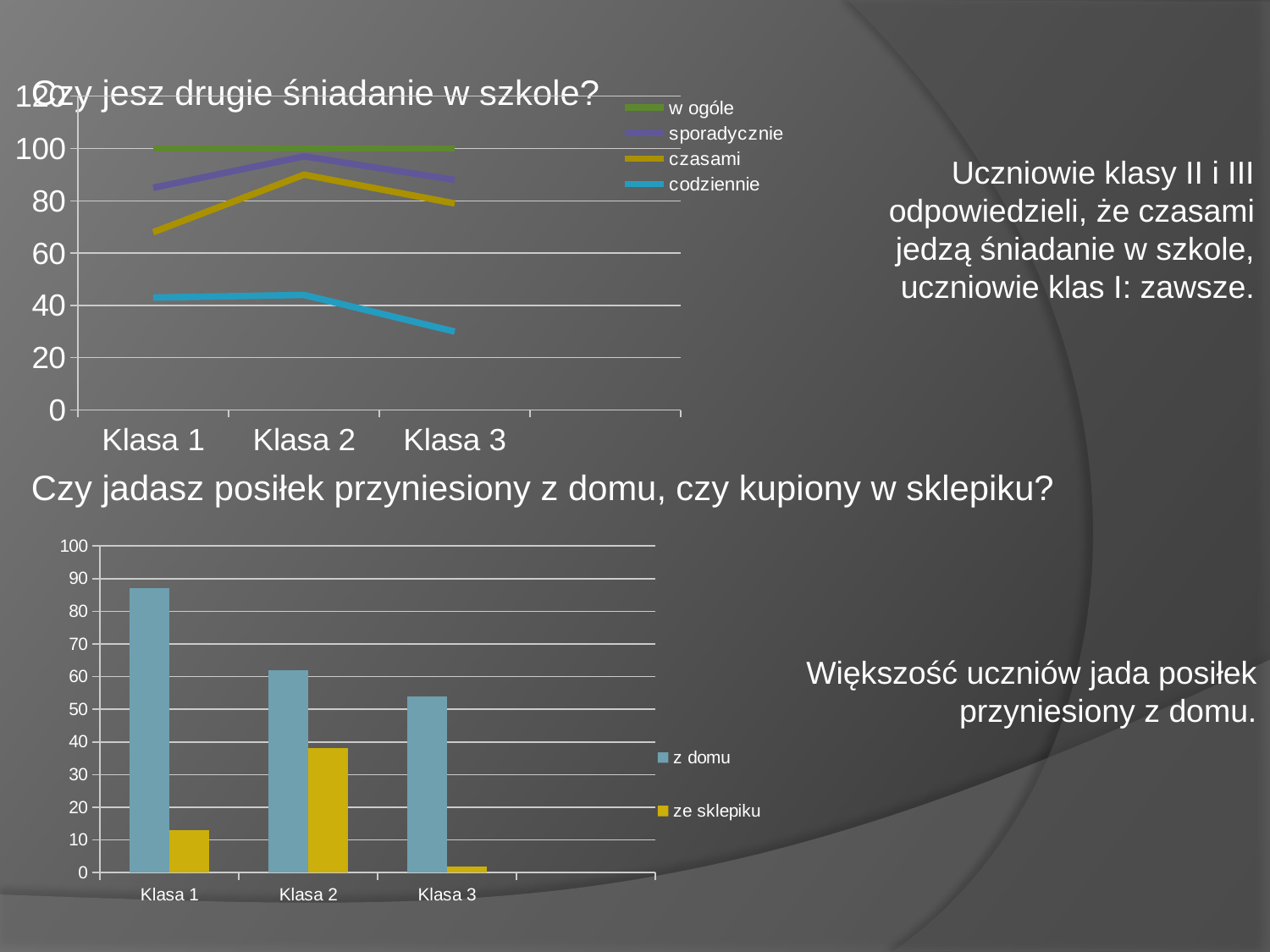
In the bottom chart, how many classes (categories) are shown on the x axis? 3 In the top chart, is the value for 'codziennie' in Klasa 3 greater or less than 40? less In the bottom chart, how many series does the legend list? 2 In the bottom chart, is the value for 'z domu' in Klasa 1 greater or less than 80? greater In the bottom chart, which class has the highest value for 'z domu'? Klasa 1 In the bottom chart, is the value for 'ze sklepiku' in Klasa 2 greater or less than 30? greater In the top chart, how many series does the legend list? 4 In the bottom chart, do the 'z domu' values rise or fall from Klasa 1 to Klasa 3? fall In the bottom chart, for Klasa 2, which is larger: 'z domu' or 'ze sklepiku'? z domu What kind of chart is the bottom chart, 'Czy jadasz posiłek przyniesiony z domu, czy kupiony w sklepiku?'? bar chart What kind of chart is the top chart, 'Czy jesz drugie śniadanie w szkole?'? line chart